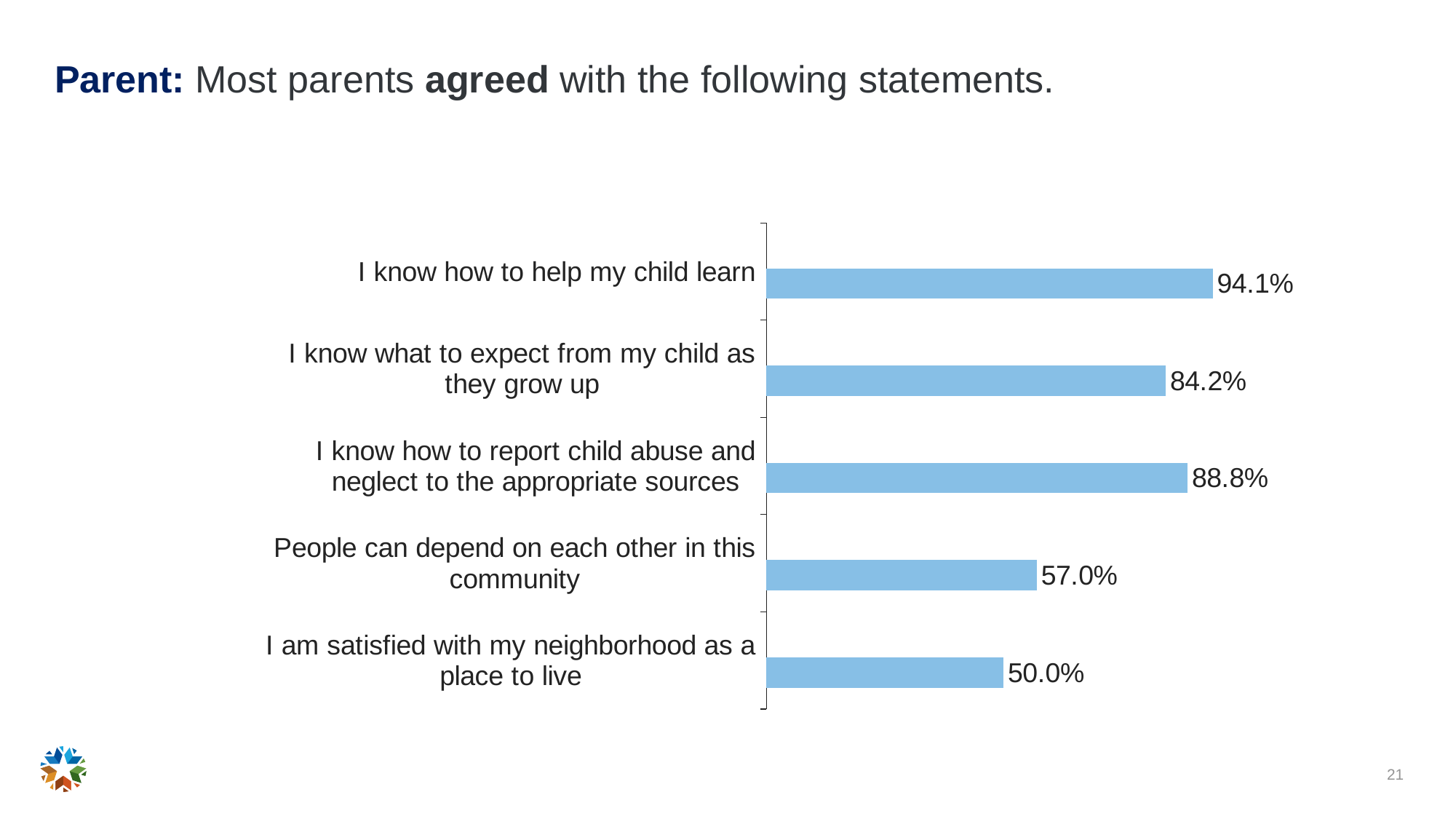
What type of chart is shown on the slide? Bar chart Which statement had a higher agreement rate: "I know what to expect from my child as they grow up" or "I know how to report child abuse and neglect to the appropriate sources"? I know how to report child abuse and neglect to the appropriate sources How many statements are shown in the chart? 5 What percentage of parents agreed with "I am satisfied with my neighborhood as a place to live"? 50.0% What percentage of parents agreed that "People can depend on each other in this community"? 57.0% Which statement had the highest percentage of parents agreeing? I know how to help my child learn Which statement had the lowest percentage of parents agreeing? I am satisfied with my neighborhood as a place to live What percentage of parents agreed with the statement "I know how to help my child learn"? 94.1% What percentage of parents agreed with "I know what to expect from my child as they grow up"? 84.2% What percentage of parents agreed with "I know how to report child abuse and neglect to the appropriate sources"? 88.8% What is the difference in percentage points between "I know how to help my child learn" and "I am satisfied with my neighborhood as a place to live"? 44.1 percentage points What is the difference in percentage points between "I know how to report child abuse and neglect to the appropriate sources" and "People can depend on each other in this community"? 31.8 percentage points